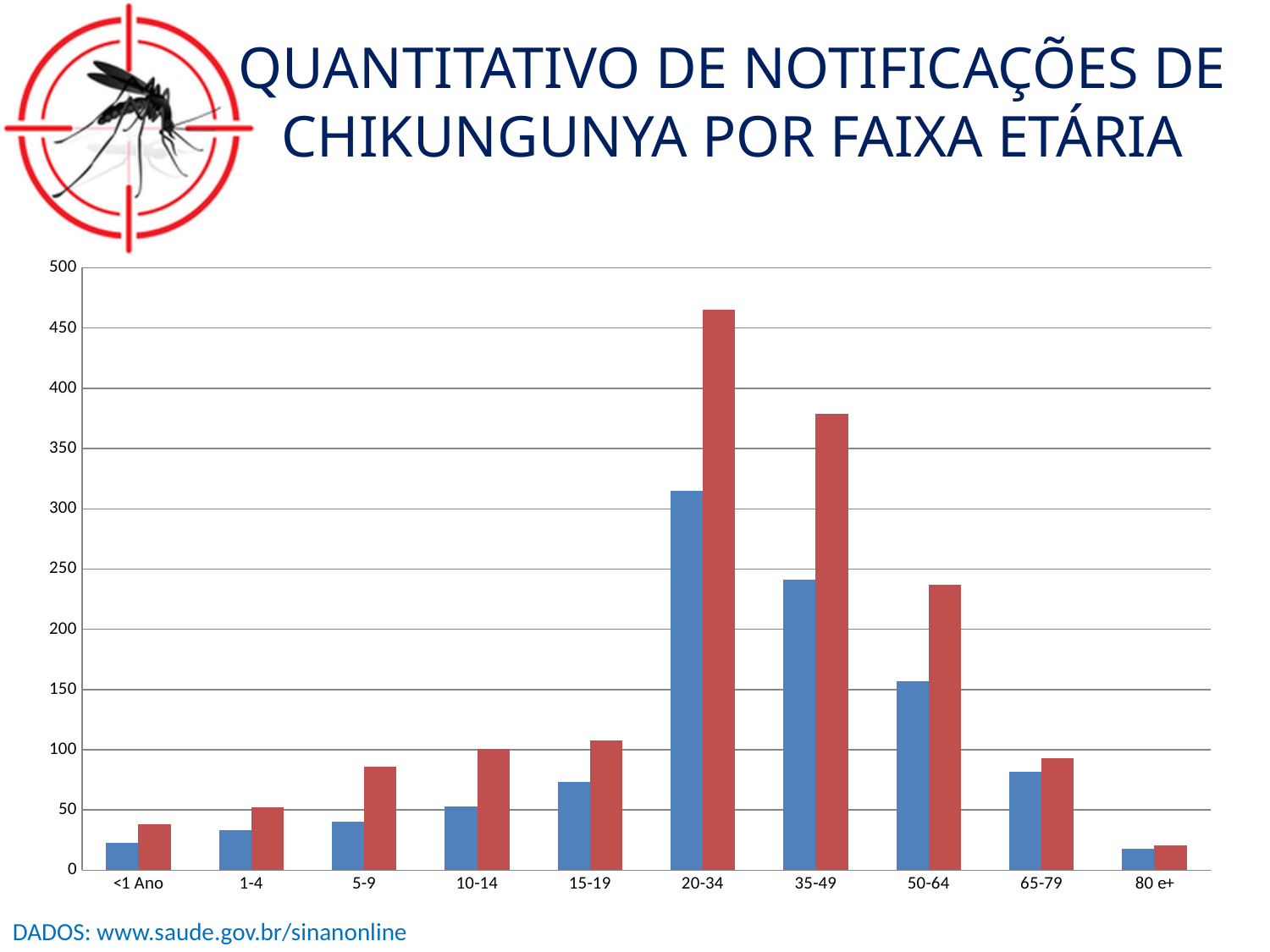
For the 20-34 age group, which bar is larger, the blue one or the red one? The red one What is the title of the chart on the slide? QUANTITATIVO DE NOTIFICAÇÕES DE CHIKUNGUNYA POR FAIXA ETÁRIA Is the value of the red bar for 35-49 greater or less than 350? greater Is the value of the blue bar for <1 Ano greater or less than 50? less How many bars are plotted for each age group? 2 Which is larger, the red bar for 15-19 or the red bar for 65-79? The red bar for 15-19 Which age group has the shortest bars in the chart? 80 e+ How many age-group categories are shown on the x axis? 10 What kind of chart is shown on the slide? Bar chart Is the value of the blue bar for 20-34 greater or less than 300? greater Which age group has the tallest bars in the chart? 20-34